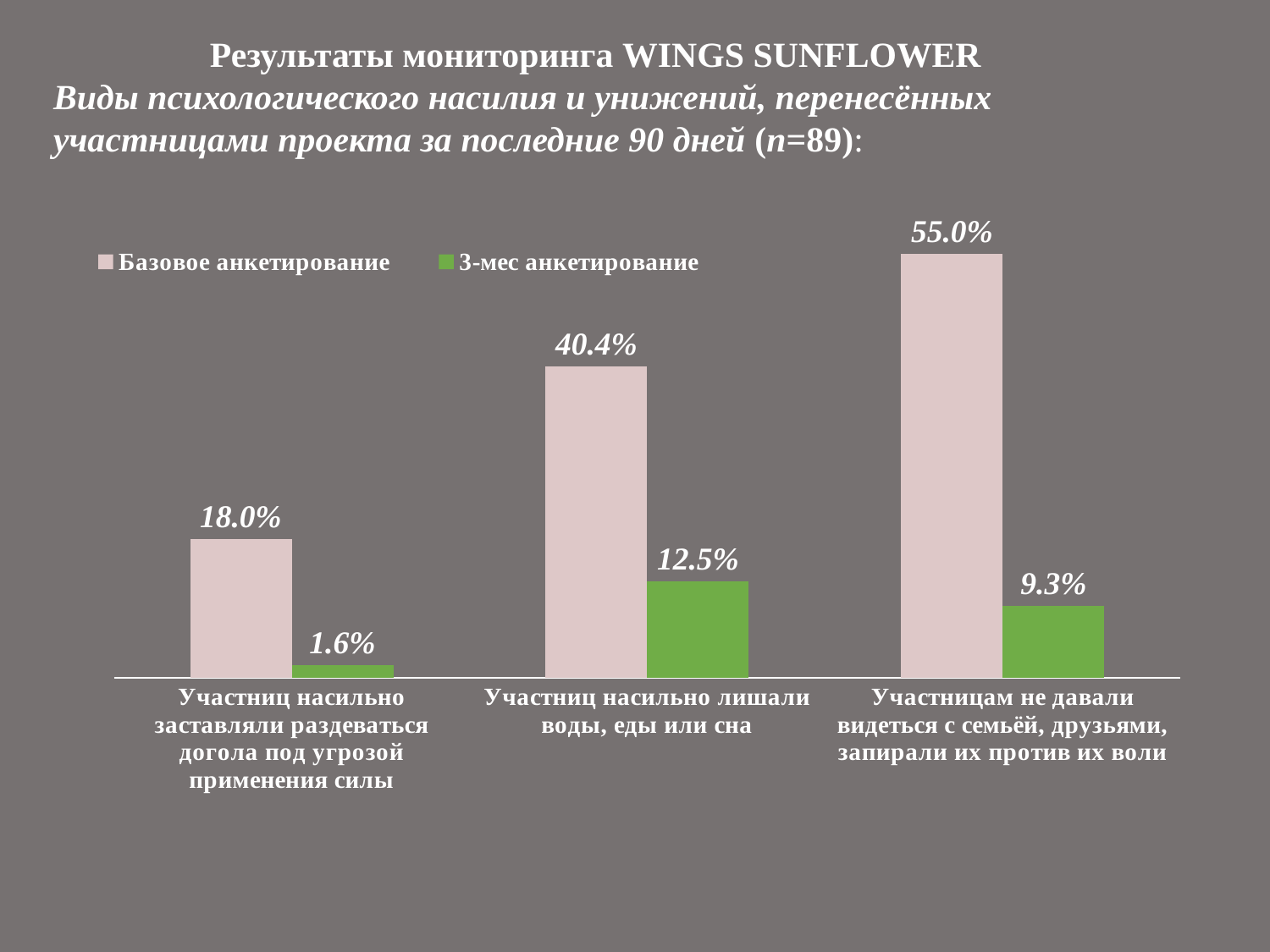
What is the difference between the "Базовое анкетирование" and "3-мес анкетирование" values for "Участницам не давали видеться с семьёй, друзьями, запирали их против их воли"? 45.7% Which is larger: the "3-мес анкетирование" value for "Участниц насильно лишали воды, еды или сна" or for "Участницам не давали видеться с семьёй, друзьями, запирали их против их воли"? Участниц насильно лишали воды, еды или сна Which colour represents the "3-мес анкетирование" series? green What is the value for "Базовое анкетирование" in the category "Участниц насильно лишали воды, еды или сна"? 40.4% How many categories are shown on the x axis? 3 What is the difference between the "Базовое анкетирование" values for "Участниц насильно лишали воды, еды или сна" and "Участниц насильно заставляли раздеваться догола под угрозой применения силы"? 22.4% Which category has the lowest value for "3-мес анкетирование"? Участниц насильно заставляли раздеваться догола под угрозой применения силы What type of chart is shown on the slide? bar chart How many series does the legend list? 2 Which category has the highest value for "Базовое анкетирование"? Участницам не давали видеться с семьёй, друзьями, запирали их против их воли What is the value for "3-мес анкетирование" in the category "Участницам не давали видеться с семьёй, друзьями, запирали их против их воли"? 9.3% What is the value for "3-мес анкетирование" in the category "Участниц насильно заставляли раздеваться догола под угрозой применения силы"? 1.6%